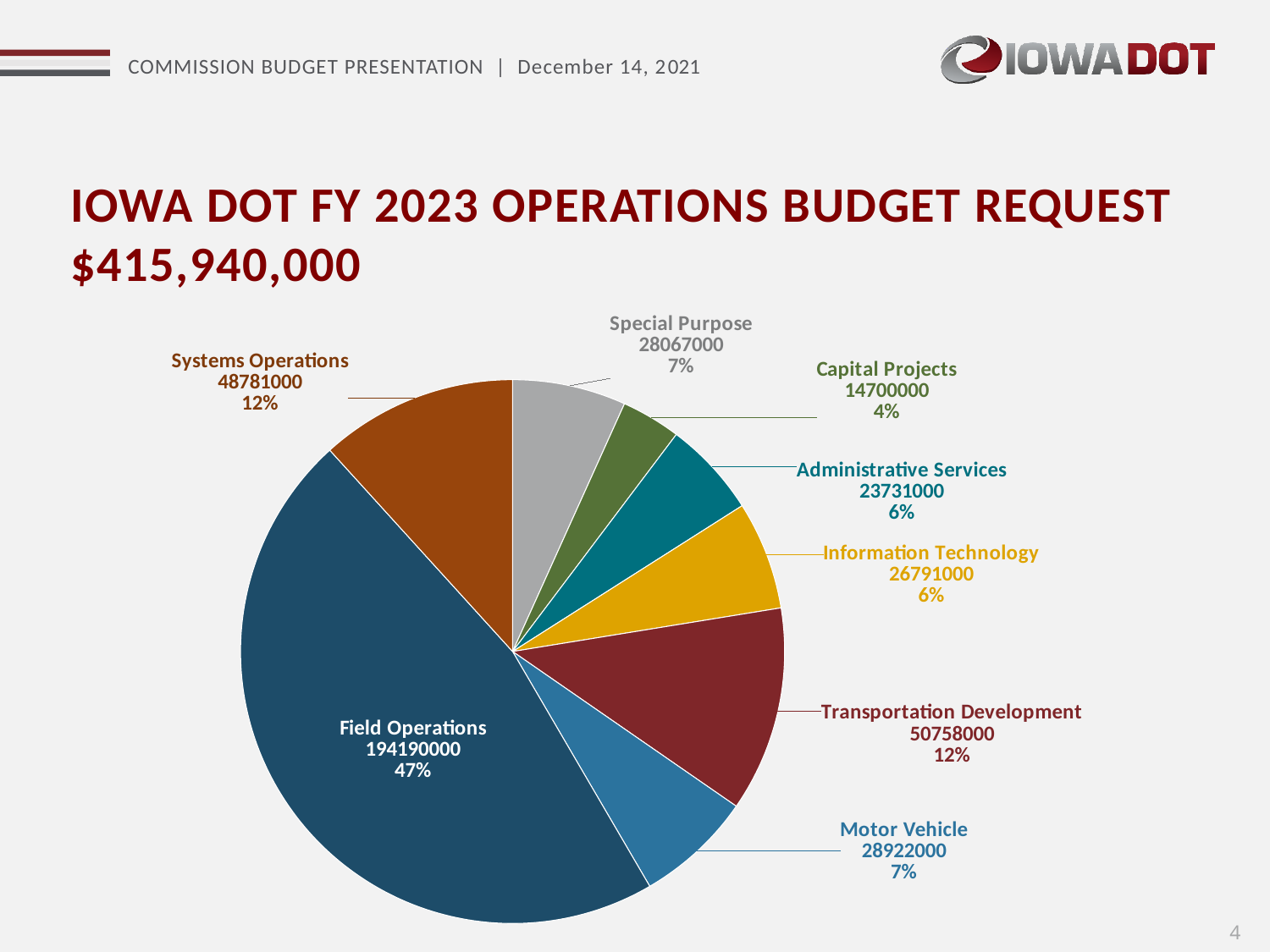
What is the difference between the values for Field Operations and Motor Vehicle? 165268000 What is the difference between the values for Transportation Development and Systems Operations? 1977000 What percentage of the pie does Transportation Development represent? 12% What kind of chart is shown on the slide? Pie chart What is the value shown for Capital Projects? 14700000 What share of the pie does Special Purpose represent? 7% What is the value shown for Field Operations? 194190000 Which category has the largest slice of the pie? Field Operations How many categories are shown in the pie chart? 8 Which is larger, the value for Information Technology or the value for Administrative Services? Information Technology What total budget request amount is stated in the slide title? $415,940,000 Which category has the smallest slice of the pie? Capital Projects